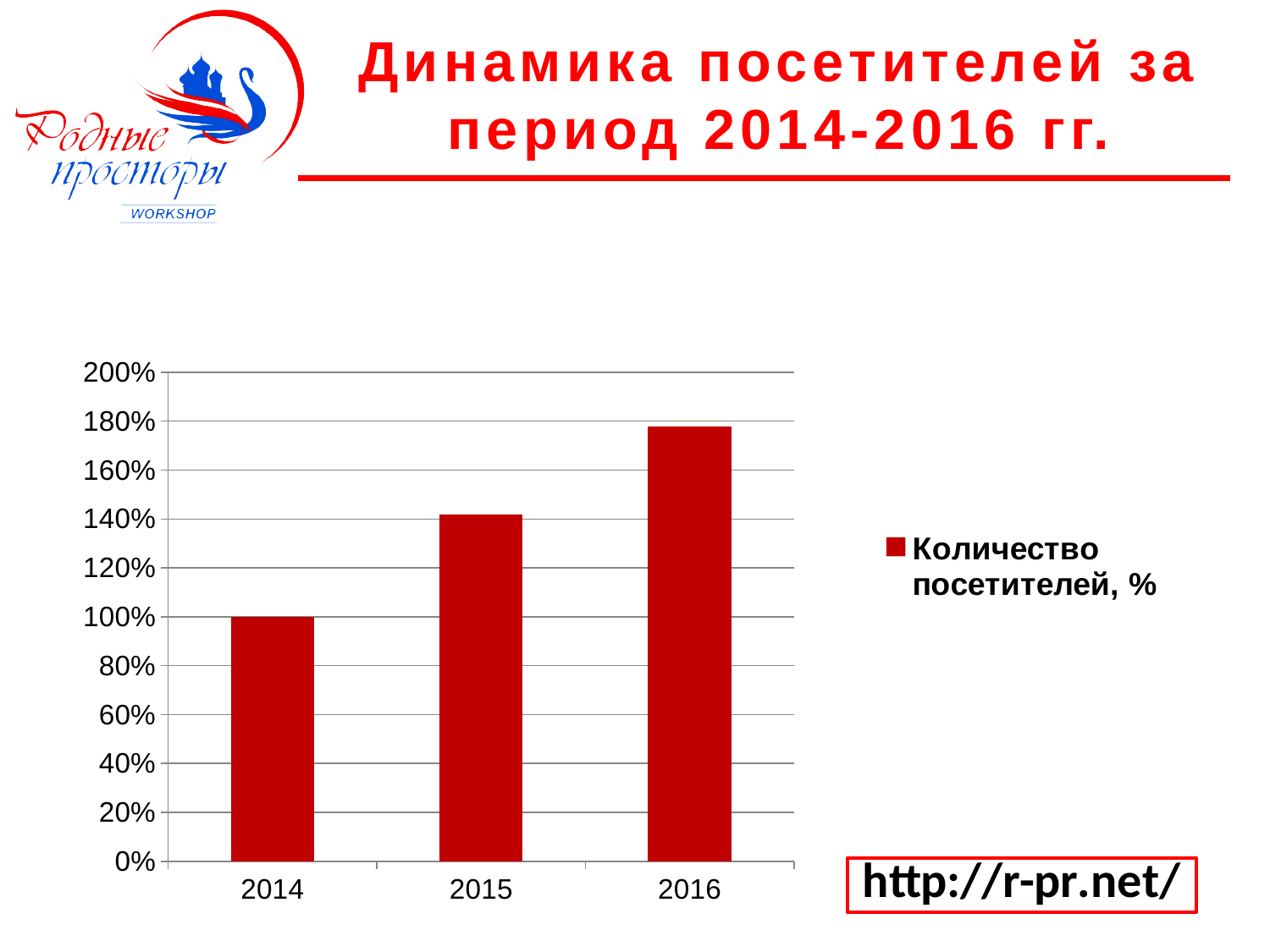
Is the value for 2016 greater or less than 160%? greater How many years (categories) are shown on the x axis of the chart? 3 Is the value for 2015 greater or less than 160%? less Which year has the lowest value in the chart? 2014 How many series does the chart legend list? 1 What is the series name shown in the chart legend? Количество посетителей, % Is the value for 2015 greater or less than 120%? greater What type of chart is shown on the slide? bar chart Which year has the highest value in the chart? 2016 What is the value for 2014 in the chart? 100% Do the values rise or fall from 2014 to 2016? rise Which is larger, the value for 2015 or the value for 2016? 2016